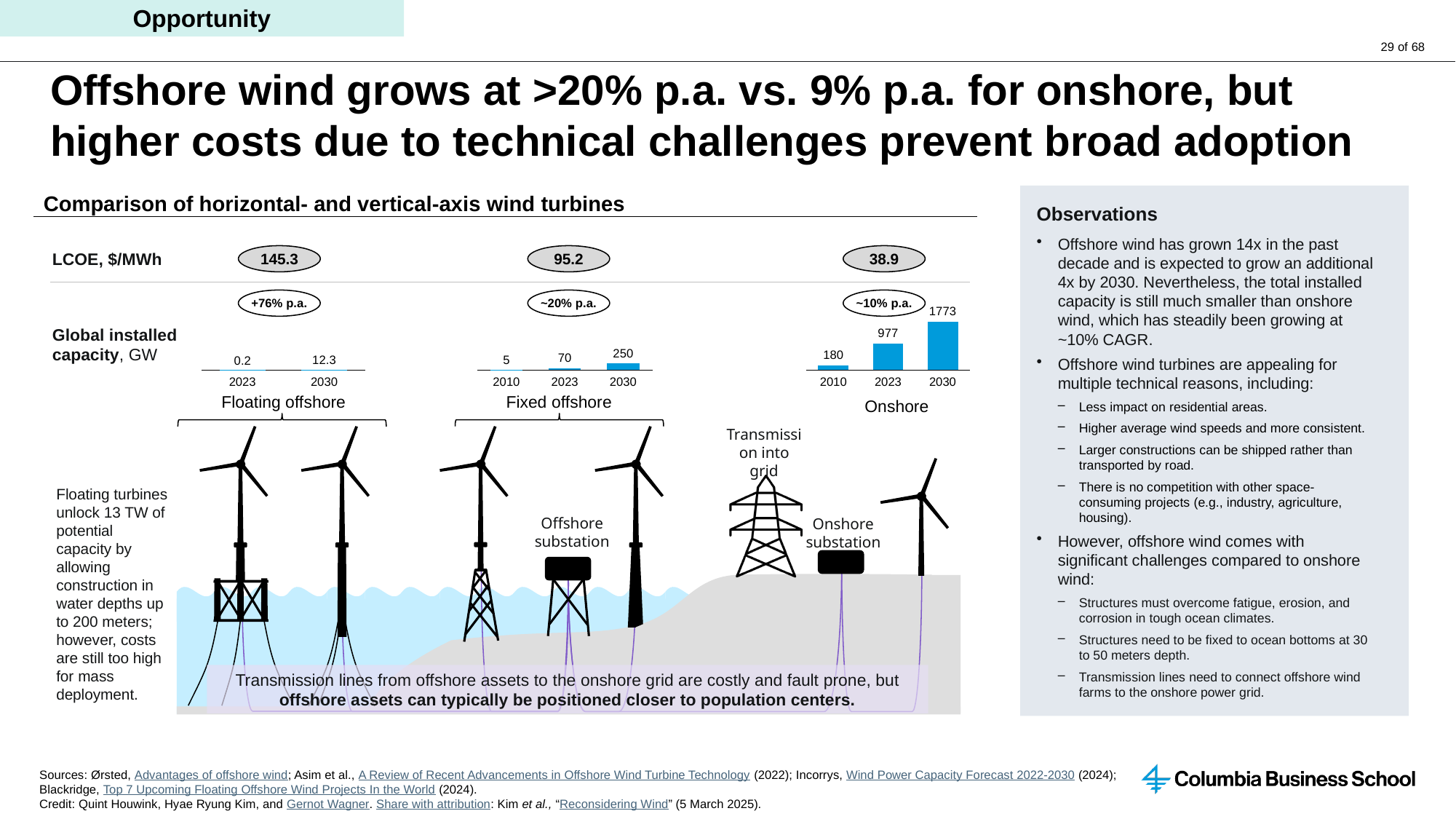
In the Onshore global installed capacity chart, what is the value for 2030? 1773 How many years are plotted in the Onshore global installed capacity chart? 3 In the Fixed offshore global installed capacity chart, do the values rise or fall from 2010 to 2030? Rise Which is larger: the 2030 value in the Fixed offshore chart or the 2010 value in the Onshore chart? 2030 value in the Fixed offshore chart How many years are plotted in the Floating offshore global installed capacity chart? 2 In the Onshore global installed capacity chart, which year has the highest value? 2030 In the Onshore global installed capacity chart, what is the difference between the 2030 and 2023 values? 796 What type of chart is used to show global installed capacity for Onshore wind? Bar chart In the Fixed offshore global installed capacity chart, what is the difference between the 2030 and 2023 values? 180 In the Floating offshore global installed capacity chart, what is the value for 2030? 12.3 In the Fixed offshore global installed capacity chart, what is the value for 2023? 70 In the Fixed offshore global installed capacity chart, which year has the lowest value? 2010